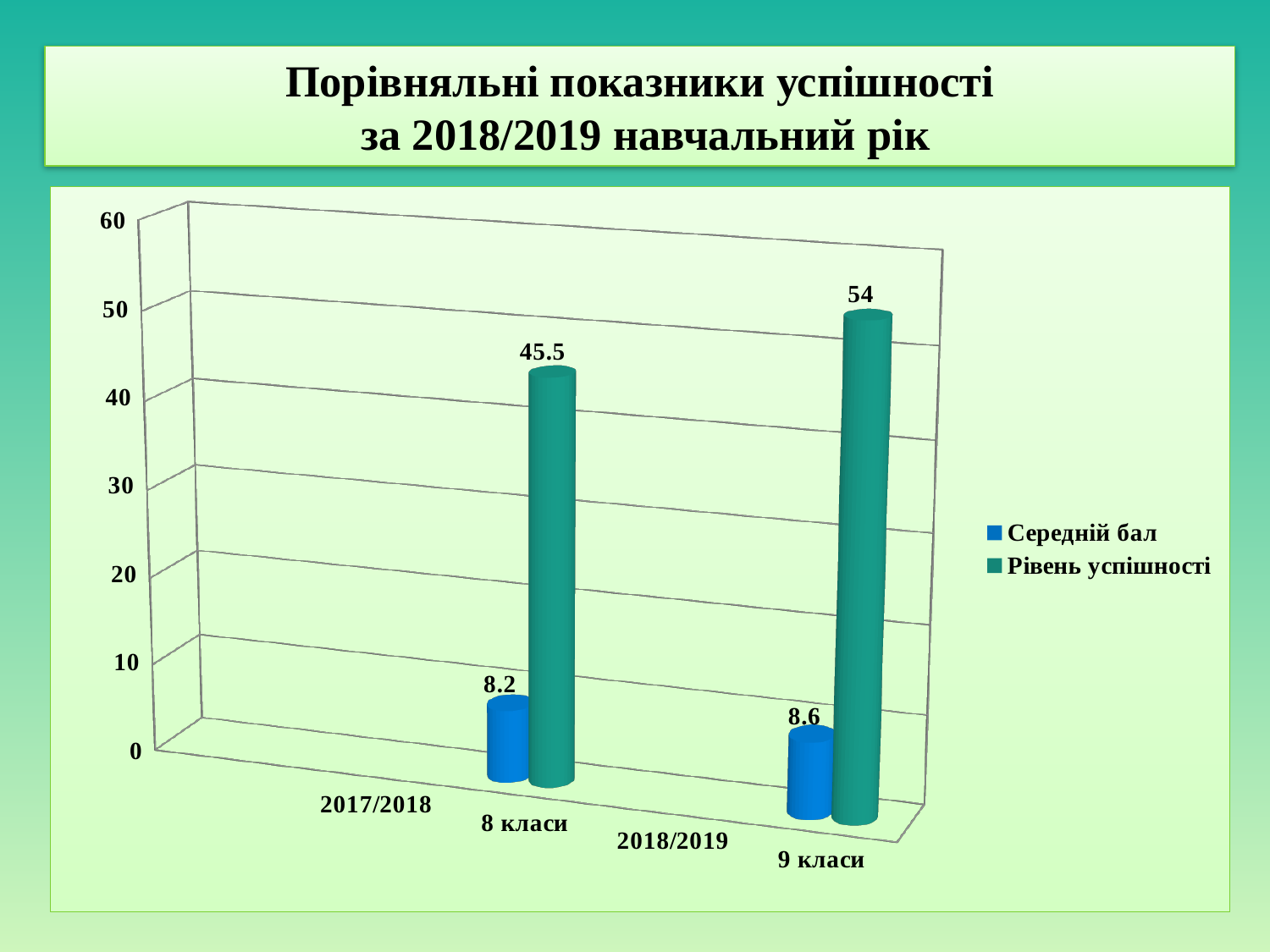
What is the value of Середній бал for 2017/2018 (8 класи)? 8.2 What is the value of Рівень успішності for 2017/2018 (8 класи)? 45.5 How many series does the legend list? 2 What is the difference in Середній бал between 2018/2019 and 2017/2018? 0.4 Which category has the higher Рівень успішності? 2018/2019 (9 класи) Which category has the lower Середній бал? 2017/2018 (8 класи) What is the value of Середній бал for 2018/2019 (9 класи)? 8.6 Which series is shown in blue in the legend? Середній бал What is the difference in Рівень успішності between 2018/2019 and 2017/2018? 8.5 What is the value of Рівень успішності for 2018/2019 (9 класи)? 54 Is the Рівень успішності for 2018/2019 greater or less than 50? greater What kind of chart is shown on the slide? Bar chart